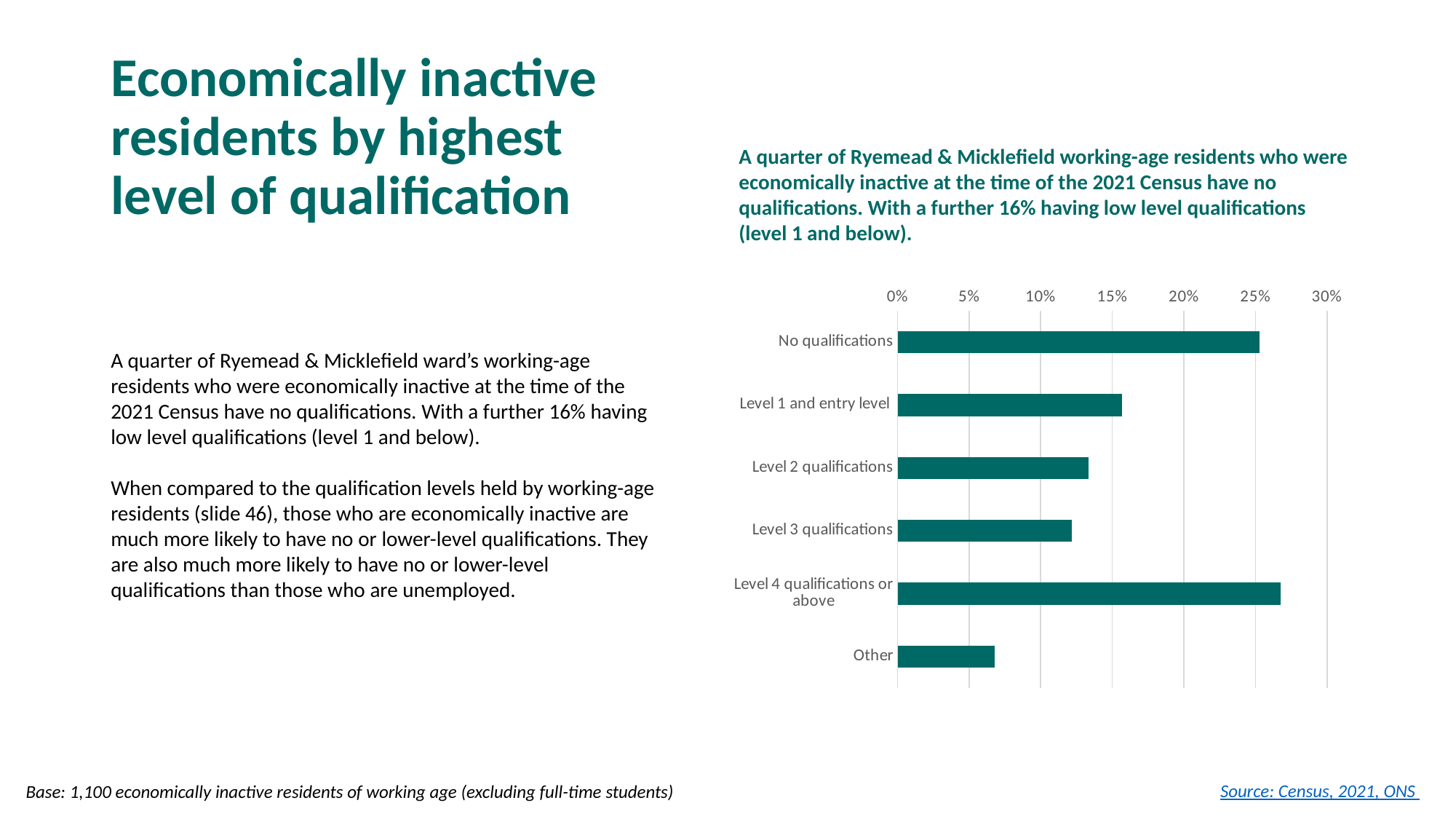
Is the value for Other greater or less than 10%? less Which is larger, the value for Level 1 and entry level or the value for Other? Level 1 and entry level Is the value for Level 3 qualifications greater or less than 15%? less How many qualification categories are plotted in the chart? 6 Which qualification category has the longest bar? Level 4 qualifications or above Which qualification category has the shortest bar? Other What kind of chart is shown on the slide? bar chart Is the value for Level 4 qualifications or above greater or less than 25%? greater What is the highest value shown on the chart's percentage axis? 30% Which is larger, the value for No qualifications or the value for Level 2 qualifications? No qualifications